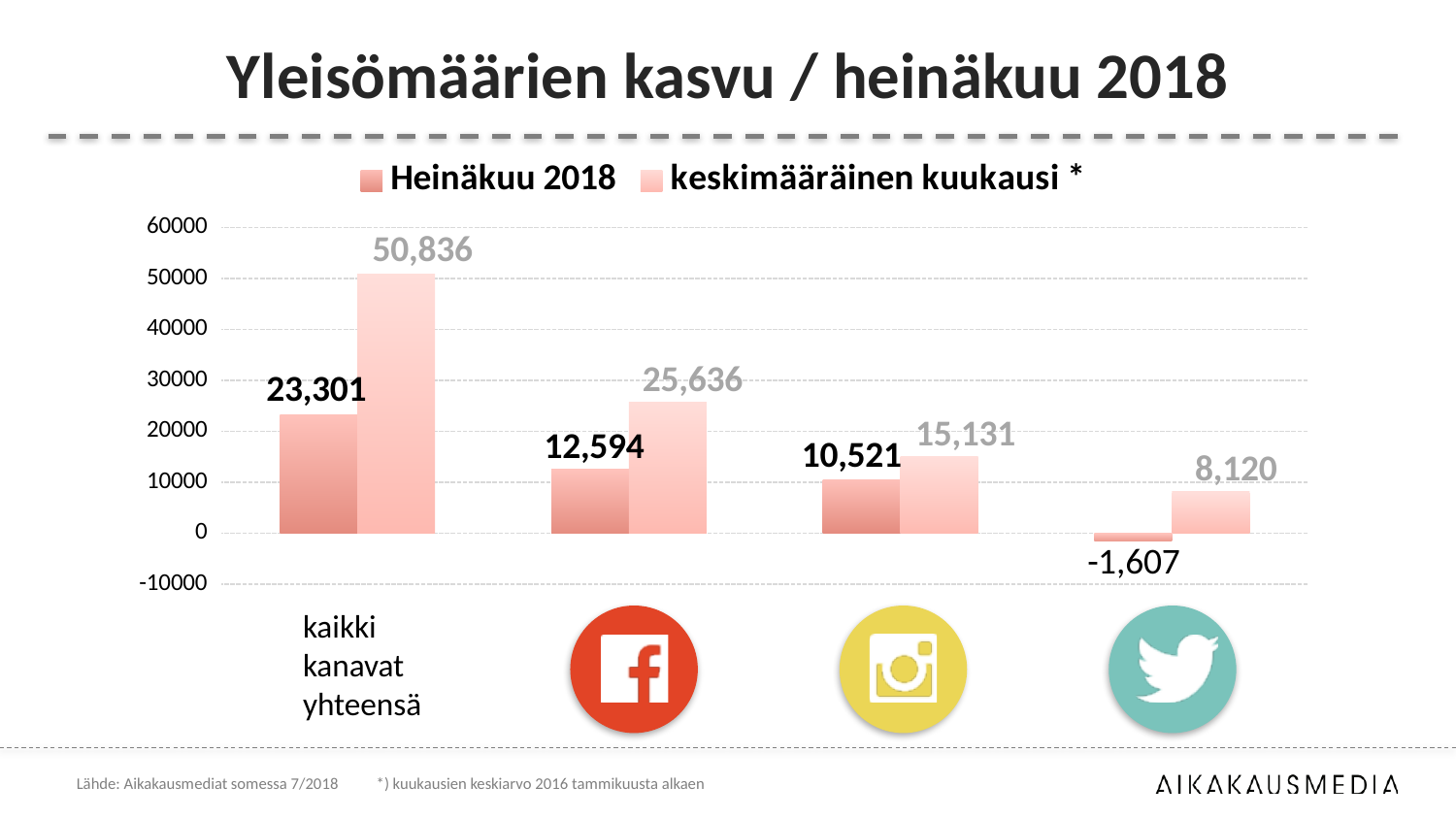
What kind of chart is shown on the slide? bar chart What is the 'keskimääräinen kuukausi *' value for 'kaikki kanavat yhteensä'? 50,836 What is the difference between the 'keskimääräinen kuukausi *' and Heinäkuu 2018 values for the Facebook category? 13,042 Which category has the highest 'keskimääräinen kuukausi *' value? kaikki kanavat yhteensä Which category has the lowest Heinäkuu 2018 value? Twitter How many series does the legend list? 2 What is the 'keskimääräinen kuukausi *' value for the Instagram category? 15,131 What is the Heinäkuu 2018 value for the Twitter category? -1,607 How many categories are shown on the x axis? 4 What is the Heinäkuu 2018 value for 'kaikki kanavat yhteensä'? 23,301 For the Instagram category, which is larger: the Heinäkuu 2018 value or the 'keskimääräinen kuukausi *' value? keskimääräinen kuukausi * What is the title of the slide? Yleisömäärien kasvu / heinäkuu 2018